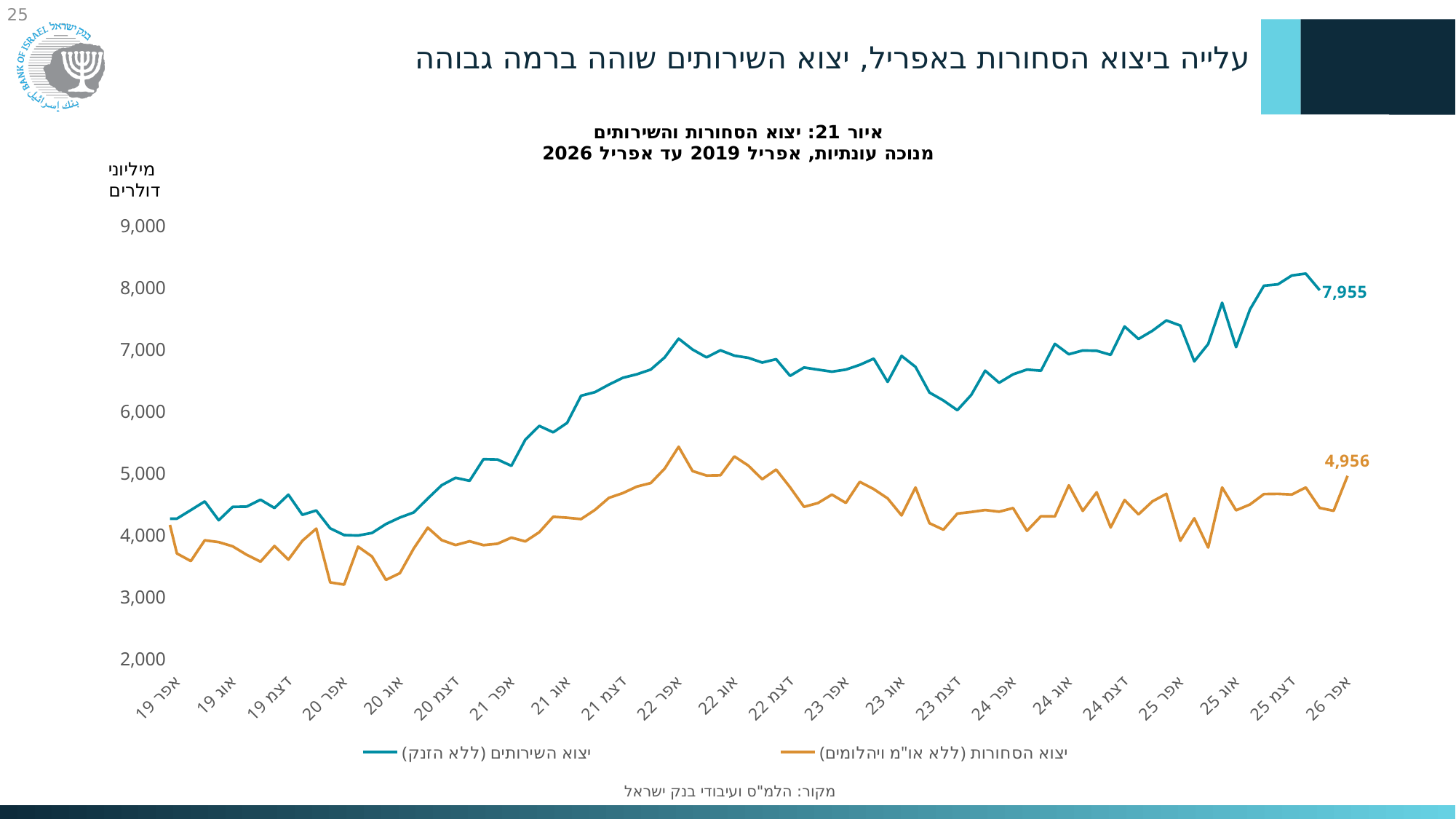
Overall, does the services exports series rise or fall from April 2019 to April 2026? Rise Is the value of the goods exports series at April 2020 (אפר 20) greater or less than 4,000? less Which colour is used for the goods exports (יצוא הסחורות) series? Orange Is the value of the goods exports series at April 2022 (אפר 22) greater or less than 5,000? greater Is the value of the services exports series at April 2022 (אפר 22) greater or less than 6,000? greater What is the value of the goods exports (יצוא הסחורות (ללא או"מ ויהלומים)) series at the last point, April 2026 (אפר 26)? 4,956 What unit is shown on the y axis of the chart? מיליוני דולרים What is the difference between the labelled April 2026 values of services exports (7,955) and goods exports (4,956)? 2,999 How many series does the legend list? 2 What kind of chart is shown on the slide? Line chart What is the value of the services exports (יצוא השירותים (ללא הזנק)) series at the last point, April 2026 (אפר 26)? 7,955 At April 2026 (אפר 26), which series has the larger value: services exports or goods exports? Services exports (יצוא השירותים)